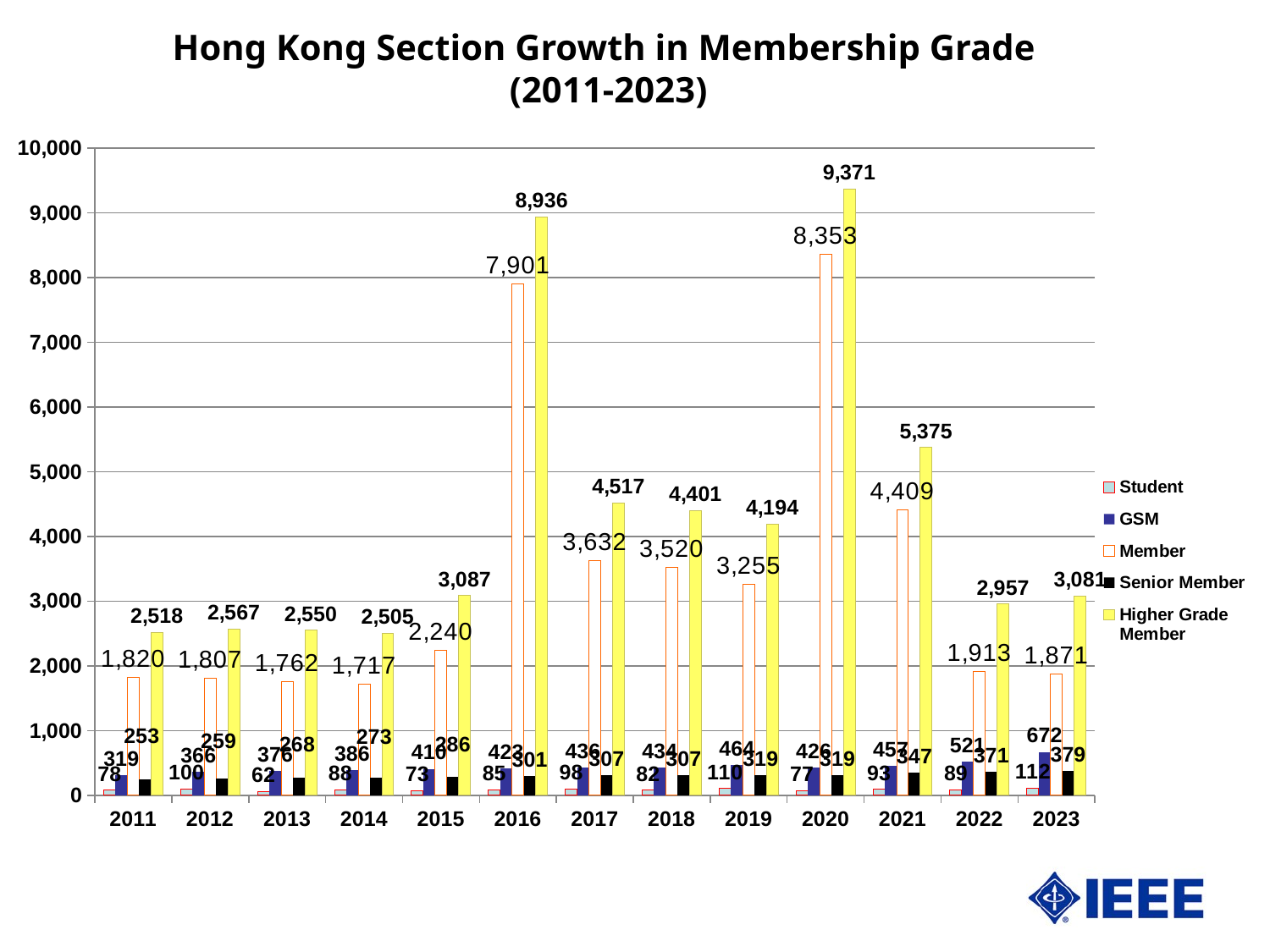
In 2021, which is larger: the Member value or the Higher Grade Member value? Higher Grade Member What is the value for Member in 2016? 7,901 What is the value for Higher Grade Member in 2020? 9,371 How many series does the legend list? 5 In which year is the Student value lowest? 2013 What kind of chart is shown on the slide? bar chart What is the GSM value in 2023? 672 What is the Senior Member value in 2023? 379 In which year is the Higher Grade Member value highest? 2020 Overall, do the GSM values rise or fall from 2011 to 2023? rise How many years are shown on the x axis? 13 What is the difference between the Higher Grade Member values in 2020 and 2016? 435